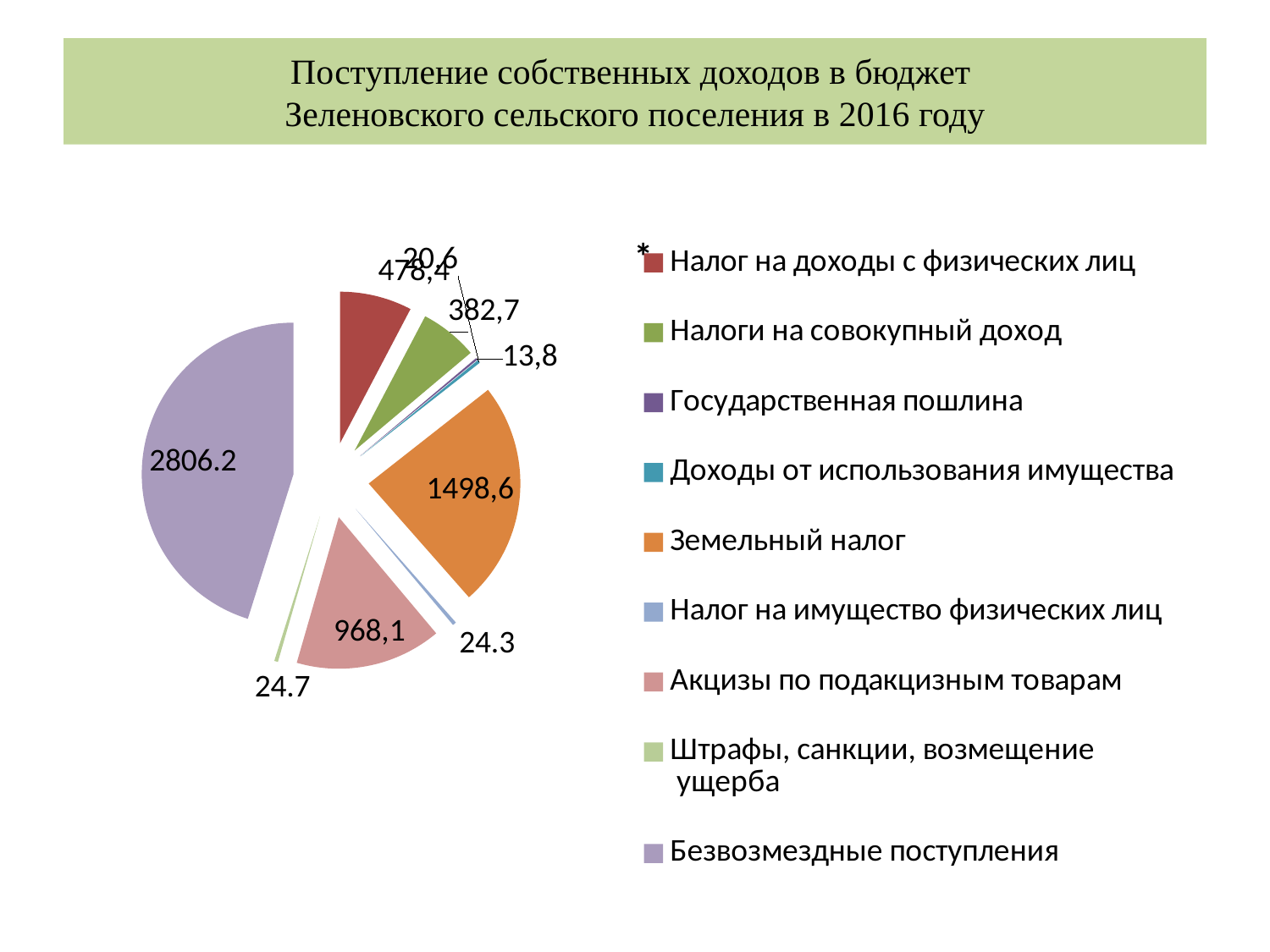
What is the value for Безвозмездные поступления? 2806.2 What is the value for Налог на доходы с физических лиц? 478,4 What is the difference between Налог на доходы с физических лиц and Налоги на совокупный доход? 95,7 How many categories does the legend list? 9 What is the value for Налоги на совокупный доход? 382,7 What is the value for Акцизы по подакцизным товарам? 968,1 Which category has the largest slice of the pie? Безвозмездные поступления What is the value for Земельный налог? 1498,6 Which is larger, Земельный налог or Акцизы по подакцизным товарам? Земельный налог What type of chart is shown on the slide? pie chart What is the difference between Земельный налог and Акцизы по подакцизным товарам? 530,5 What is the title of the slide? Поступление собственных доходов в бюджет Зеленовского сельского поселения в 2016 году